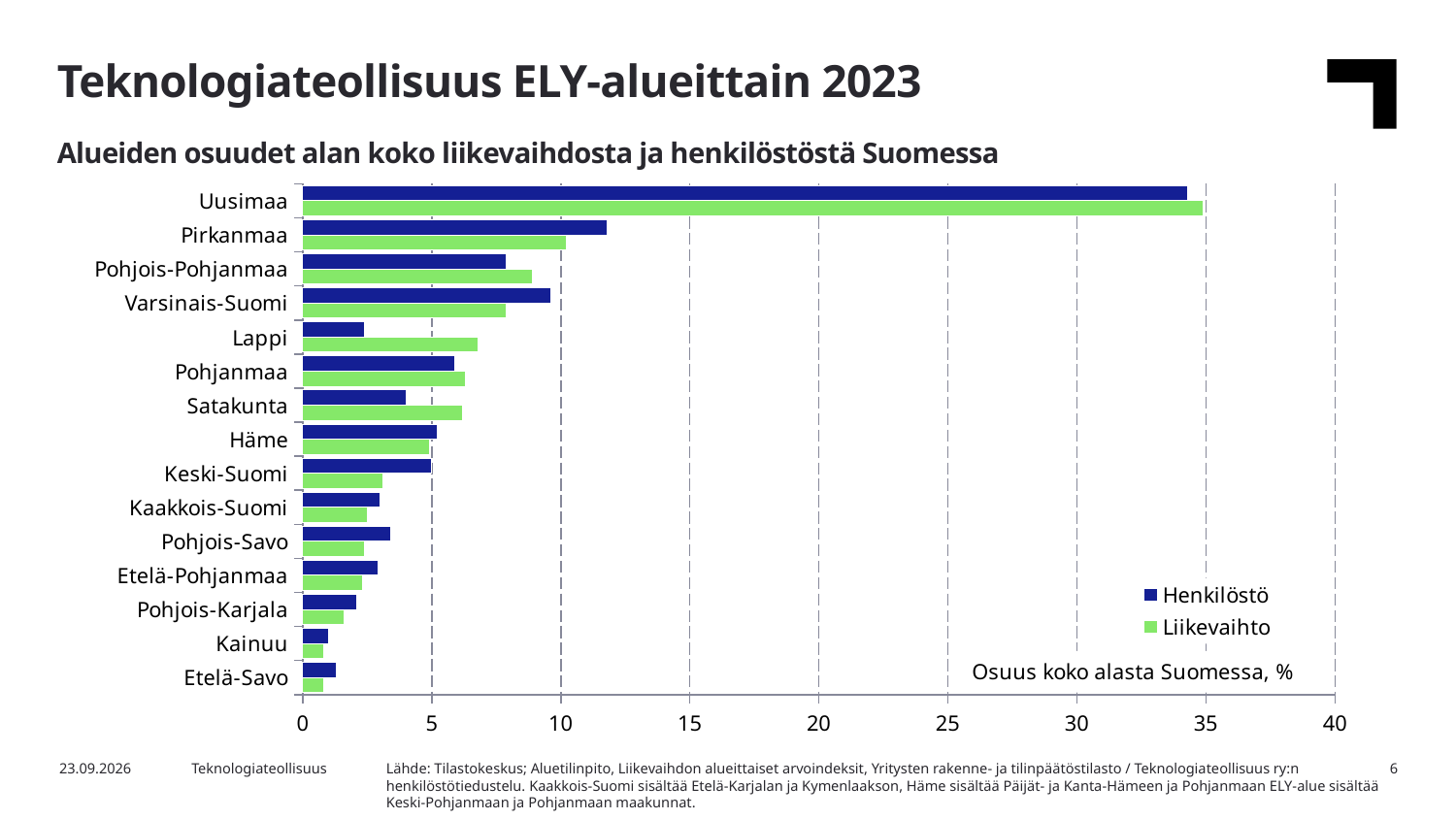
For Varsinais-Suomi, which is larger: the Henkilöstö share or the Liikevaihto share? Henkilöstö For Pohjois-Pohjanmaa, which is larger: the Henkilöstö share or the Liikevaihto share? Liikevaihto How many regions (categories) are plotted in the chart? 15 Is the Henkilöstö value for Uusimaa greater or less than 30? greater Which region has the highest Henkilöstö share? Uusimaa Which region has the highest Liikevaihto share? Uusimaa Is the Henkilöstö value for Pirkanmaa greater or less than 10? greater What kind of chart is shown on the slide? Bar chart How many series does the legend list? 2 What are the two series named in the legend? Henkilöstö and Liikevaihto Is the Henkilöstö value for Lappi greater or less than 5? less